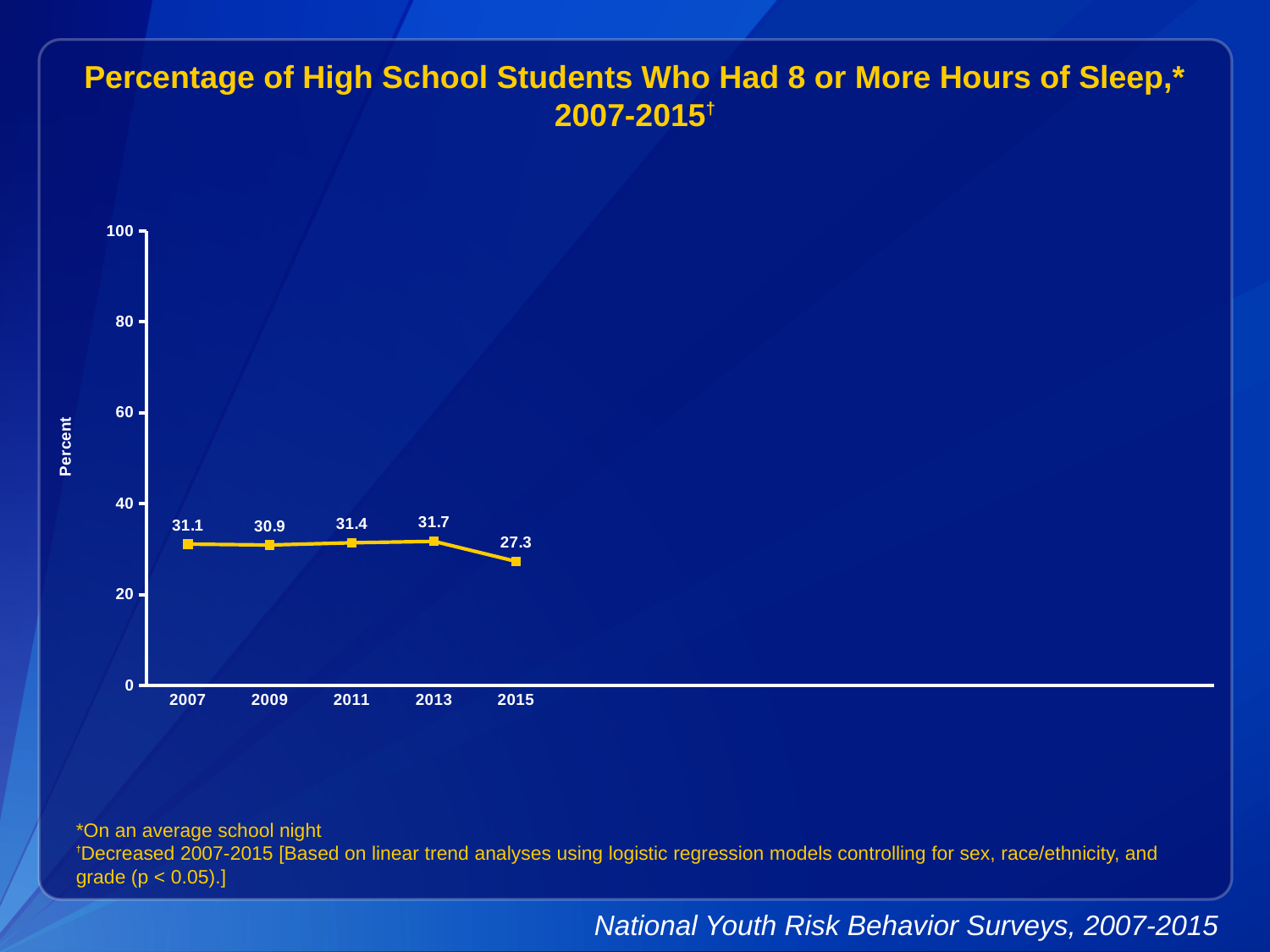
Is the value for 2015 greater or less than 40? less What kind of chart is shown on the slide? line chart How many years are plotted on the chart? 5 Which is larger, the value for 2009 or the value for 2011? 2011 Which year has the lowest percentage? 2015 What is the label on the y axis? Percent What is the value plotted for 2015? 27.3 What percentage of high school students had 8 or more hours of sleep in 2007? 31.1 Does the percentage rise or fall from 2013 to 2015? fall What is the value plotted for 2011? 31.4 What is the difference between the 2013 value and the 2015 value? 4.4 Which year has the highest percentage? 2013